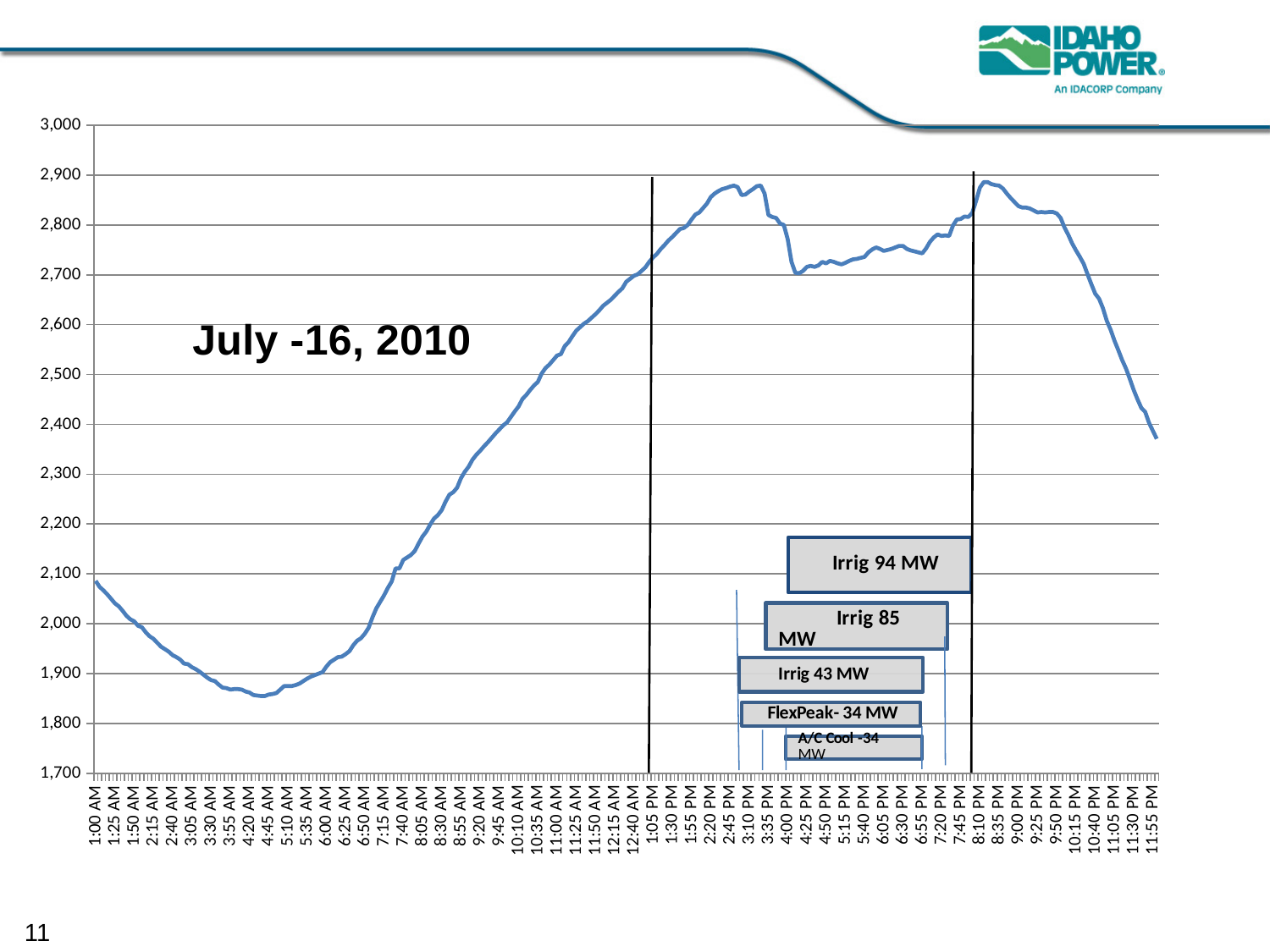
Is the value at 4:25 PM greater or less than 2,800? less What MW value is printed in the FlexPeak annotation box? 34 MW What is the largest MW value printed in the Irrig annotation boxes? 94 MW What date is shown in the chart's title text? July -16, 2010 What is the highest value shown on the vertical axis? 3,000 Is the value at 4:45 AM greater or less than 1,900? less Is the value at 1:00 AM greater or less than 2,000? greater Does the line rise or fall between 4:45 AM and 1:05 PM? rise What kind of chart is shown on the slide? line chart Does the line rise or fall between 8:10 PM and 11:55 PM? fall